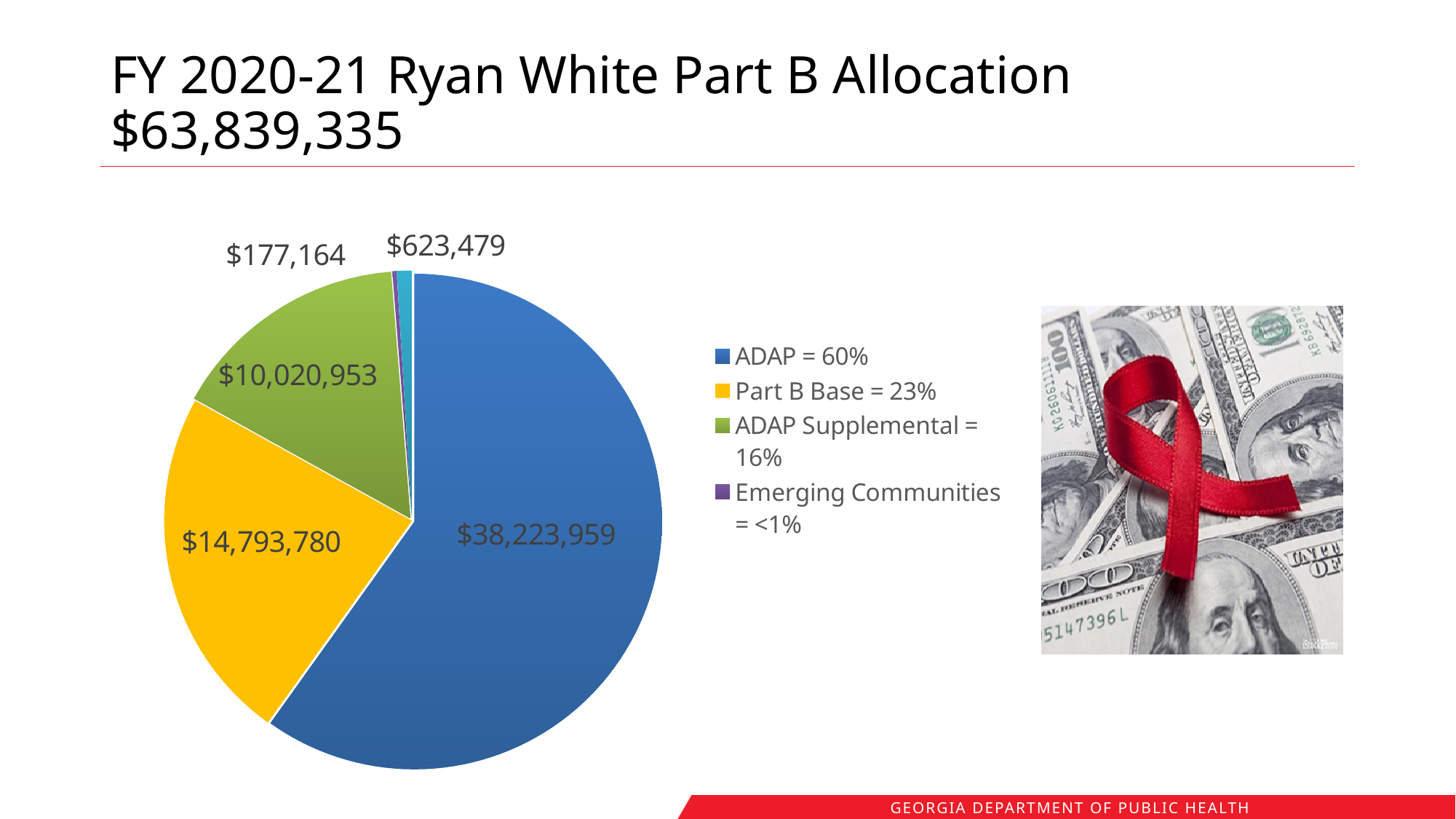
Which category has the largest slice of the pie? ADAP What kind of chart is shown on the slide? pie chart What is the dollar value of the ADAP Supplemental slice? $10,020,953 What is the dollar value of the ADAP slice? $38,223,959 What total allocation amount is shown in the slide title? $63,839,335 How much larger is the ADAP value than the Part B Base value? $23,430,179 What share of the allocation does ADAP represent according to the legend? 60% What share of the allocation does ADAP Supplemental represent according to the legend? 16% What share of the allocation does Part B Base represent according to the legend? 23% How many entries does the legend list? 4 Which is larger, the Part B Base slice or the ADAP Supplemental slice? Part B Base What is the dollar value of the Part B Base slice? $14,793,780